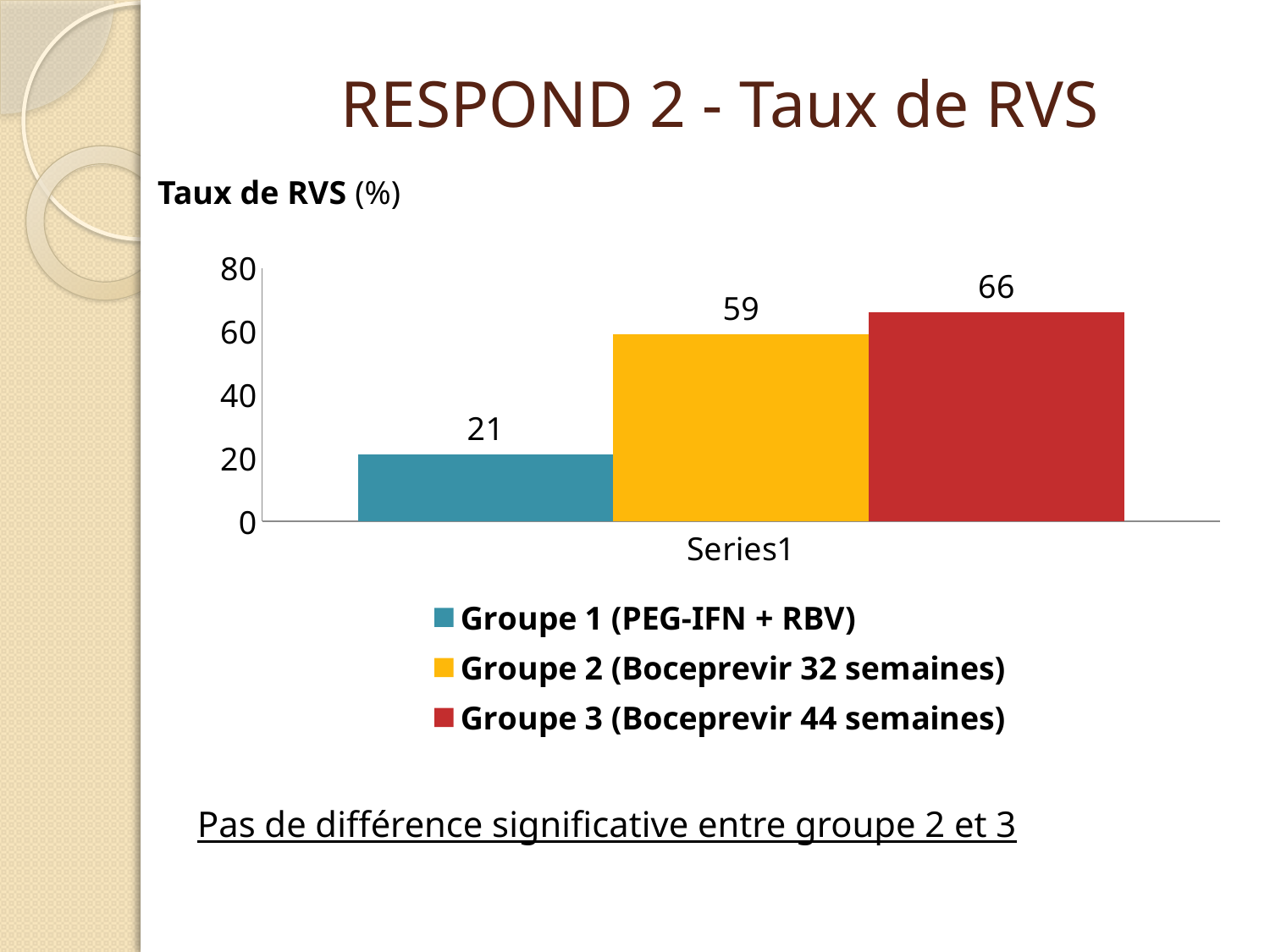
What kind of chart is shown on the slide? bar chart How many series does the legend list? 3 What is the difference between the values for Groupe 3 and Groupe 1? 45 Is the value for Groupe 1 greater or less than 40? less Which group has the highest value? Groupe 3 (Boceprevir 44 semaines) What colour is the bar for Groupe 2 (Boceprevir 32 semaines)? yellow What is the difference between the values for Groupe 3 and Groupe 2? 7 What is the value for Groupe 3 (Boceprevir 44 semaines)? 66 Which group has the lowest value? Groupe 1 (PEG-IFN + RBV) What is the value for Groupe 1 (PEG-IFN + RBV)? 21 What is the value for Groupe 2 (Boceprevir 32 semaines)? 59 Which is larger, the value for Groupe 2 or the value for Groupe 1? Groupe 2